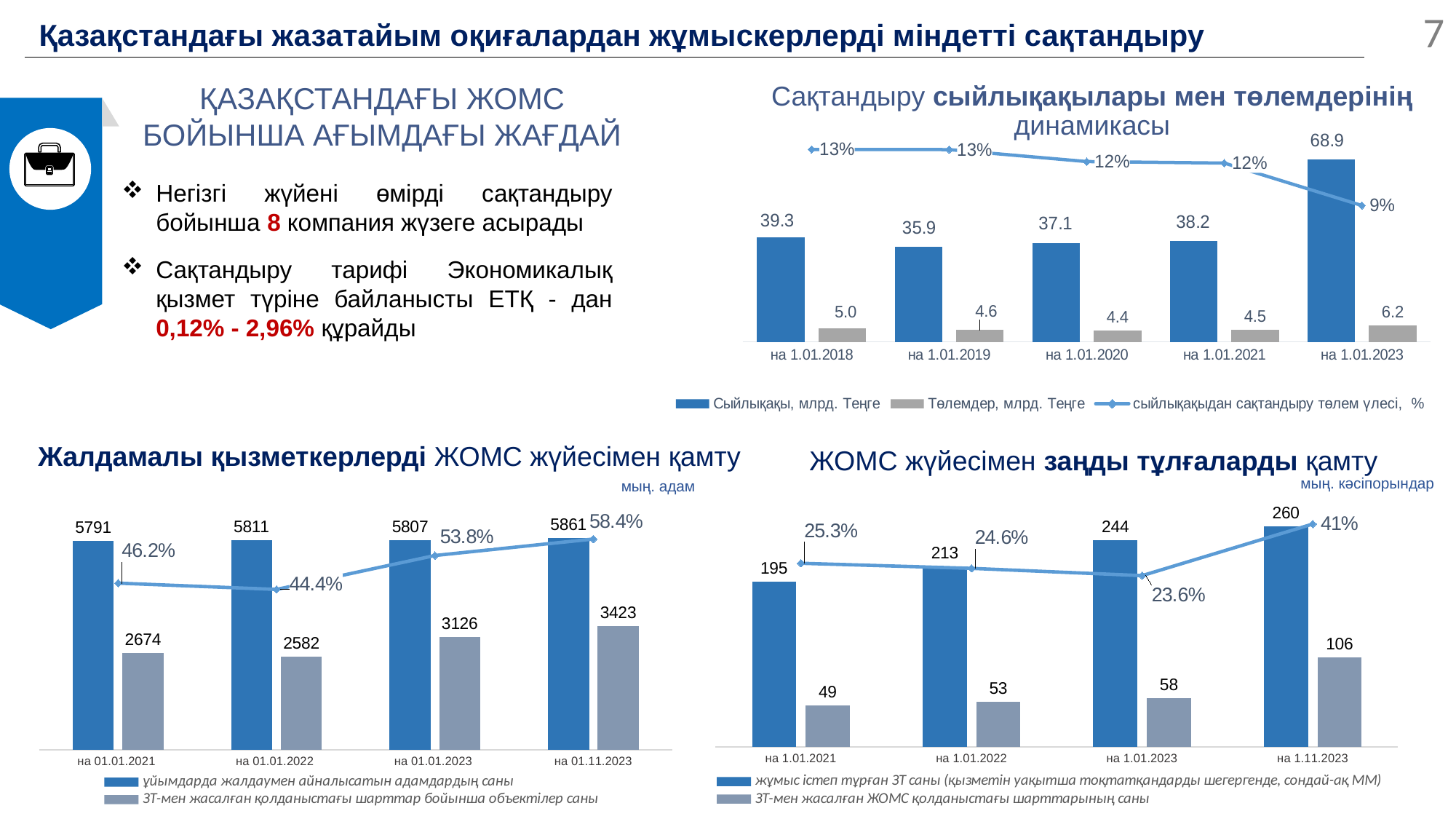
In the top-right chart 'Сақтандыру сыйлықақылары мен төлемдерінің динамикасы', what is the value of Төлемдер, млрд. Теңге for на 1.01.2020? 4.4 In the bottom-left chart 'Жалдамалы қызметкерлерді ЖОМС жүйесімен қамту', what is the coverage percentage shown for на 01.01.2023? 53.8% In the bottom-right chart 'ЖОМС жүйесімен заңды тұлғаларды қамту', what is the value of the second series (ЗТ-мен жасалған ЖОМС қолданыстағы шарттарының саны) for на 1.11.2023? 106 In the bottom-right chart 'ЖОМС жүйесімен заңды тұлғаларды қамту', how many categories are shown on the x axis? 4 In the bottom-left chart 'Жалдамалы қызметкерлерді ЖОМС жүйесімен қамту', which category has the highest value of the second series (ЗТ-мен жасалған қолданыстағы шарттар бойынша объектілер саны)? на 01.11.2023 In the top-right chart 'Сақтандыру сыйлықақылары мен төлемдерінің динамикасы', what is the difference between Сыйлықақы and Төлемдер for на 1.01.2018? 34.3 In the top-right chart 'Сақтандыру сыйлықақылары мен төлемдерінің динамикасы', what is the payment share (сыйлықақыдан сақтандыру төлем үлесі) for на 1.01.2023? 9% In the bottom-left chart 'Жалдамалы қызметкерлерді ЖОМС жүйесімен қамту', what is the value of the first series (ұйымдарда жалдаумен айналысатын адамдардың саны) for на 01.01.2022? 5811 In the bottom-right chart 'ЖОМС жүйесімен заңды тұлғаларды қамту', does the first series (жұмыс істеп тұрған ЗТ саны) rise or fall from на 1.01.2021 to на 1.11.2023? rise In the top-right chart 'Сақтандыру сыйлықақылары мен төлемдерінің динамикасы', how many series does the legend list? 3 In the top-right chart 'Сақтандыру сыйлықақылары мен төлемдерінің динамикасы', which category has the lowest value of Сыйлықақы, млрд. Теңге? на 1.01.2019 In the top-right chart 'Сақтандыру сыйлықақылары мен төлемдерінің динамикасы', what is the value of Сыйлықақы, млрд. Теңге for на 1.01.2023? 68.9